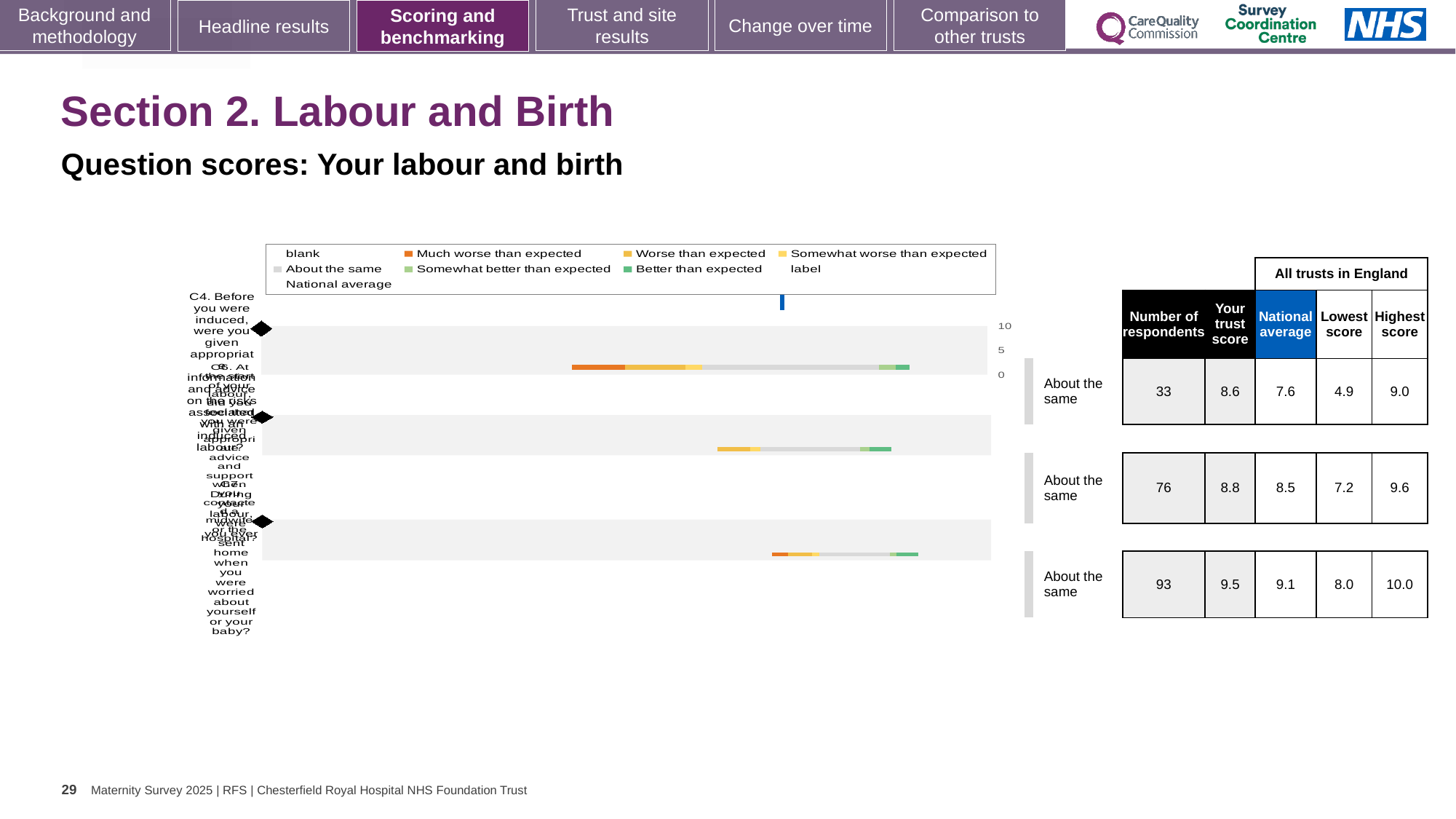
In the table next to the chart, what is the number of respondents for the top row (C4)? 33 What kind of chart is shown on the slide? bar chart For the middle (second) row, which is larger: the trust score or the national average? the trust score What is the highest score among all trusts in England for the bottom (third) row? 10.0 What is the lowest score among all trusts in England for the top row (C4)? 4.9 What is the trust score for the bottom (third) question row? 9.5 Which question row has the fewest respondents? the top row (C4) What is the national average for the middle (second) question row? 8.5 Which question row has the highest trust score? the bottom (third) row For the top row (C4), what is the difference between the trust score and the national average? 1.0 What benchmark label is shown for each of the three question rows? About the same How many question rows are plotted in the chart? 3